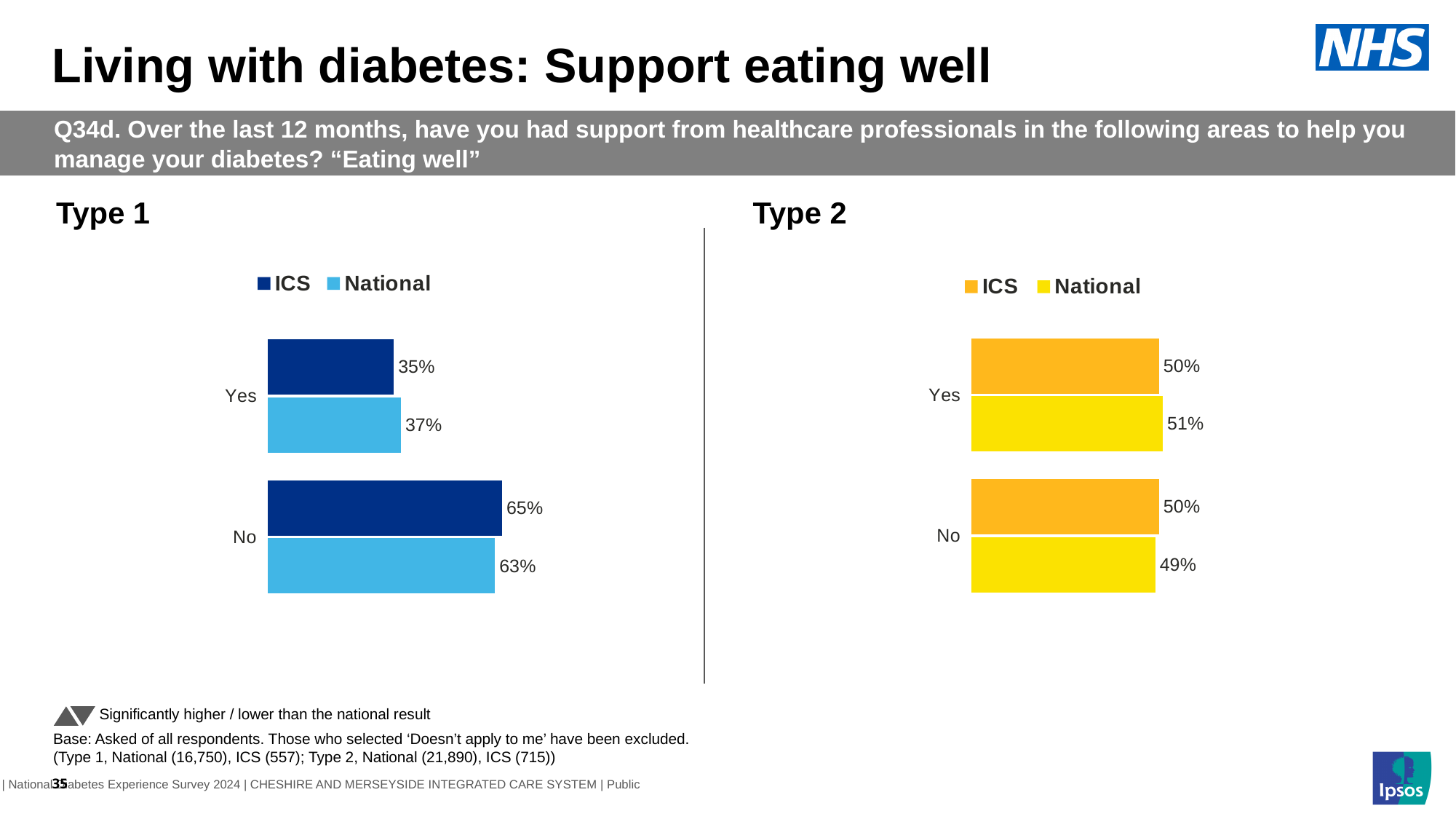
In the Type 1 chart, what is the difference between the ICS and National values for No? 2 percentage points In the Type 2 chart, what is the National value for Yes? 51% In the Type 2 chart, what is the ICS value for No? 50% In the Type 2 chart, which category has the lowest National value? No What kind of chart is the Type 1 chart? Bar chart How many series does the legend of the Type 2 chart list? 2 In the Type 1 chart, which is larger for Yes: the ICS value or the National value? National In the Type 1 chart, what is the National value for No? 63% In the Type 2 chart, what colour represents the National series? Yellow In the Type 1 chart, which category has the highest ICS value? No In the Type 1 chart, what is the ICS value for Yes? 35% In the Type 2 chart, what is the difference between the ICS and National values for No? 1 percentage point